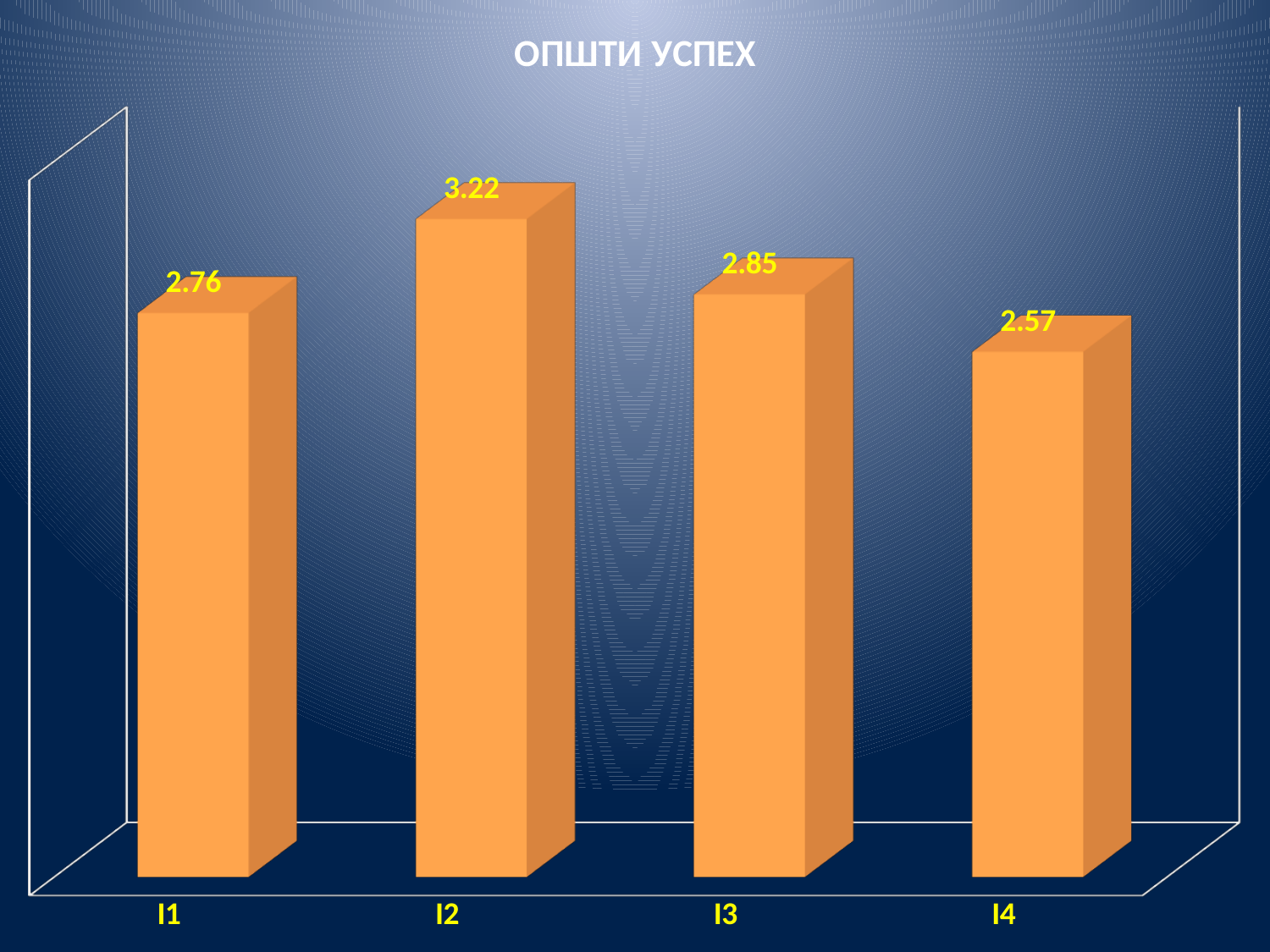
What is the difference between the values for I3 and I1? 0.09 What is the value for I2? 3.22 What is the value for I3? 2.85 What is the value for I4? 2.57 Which category has the lowest value? I4 What is the difference between the values for I2 and I4? 0.65 Which category has the highest value? I2 What kind of chart is shown on the slide? Bar chart What is the title of the chart? ОПШТИ УСПЕХ How many categories are shown in the chart? 4 What is the value for I1? 2.76 Which is larger, the value for I1 or the value for I3? I3